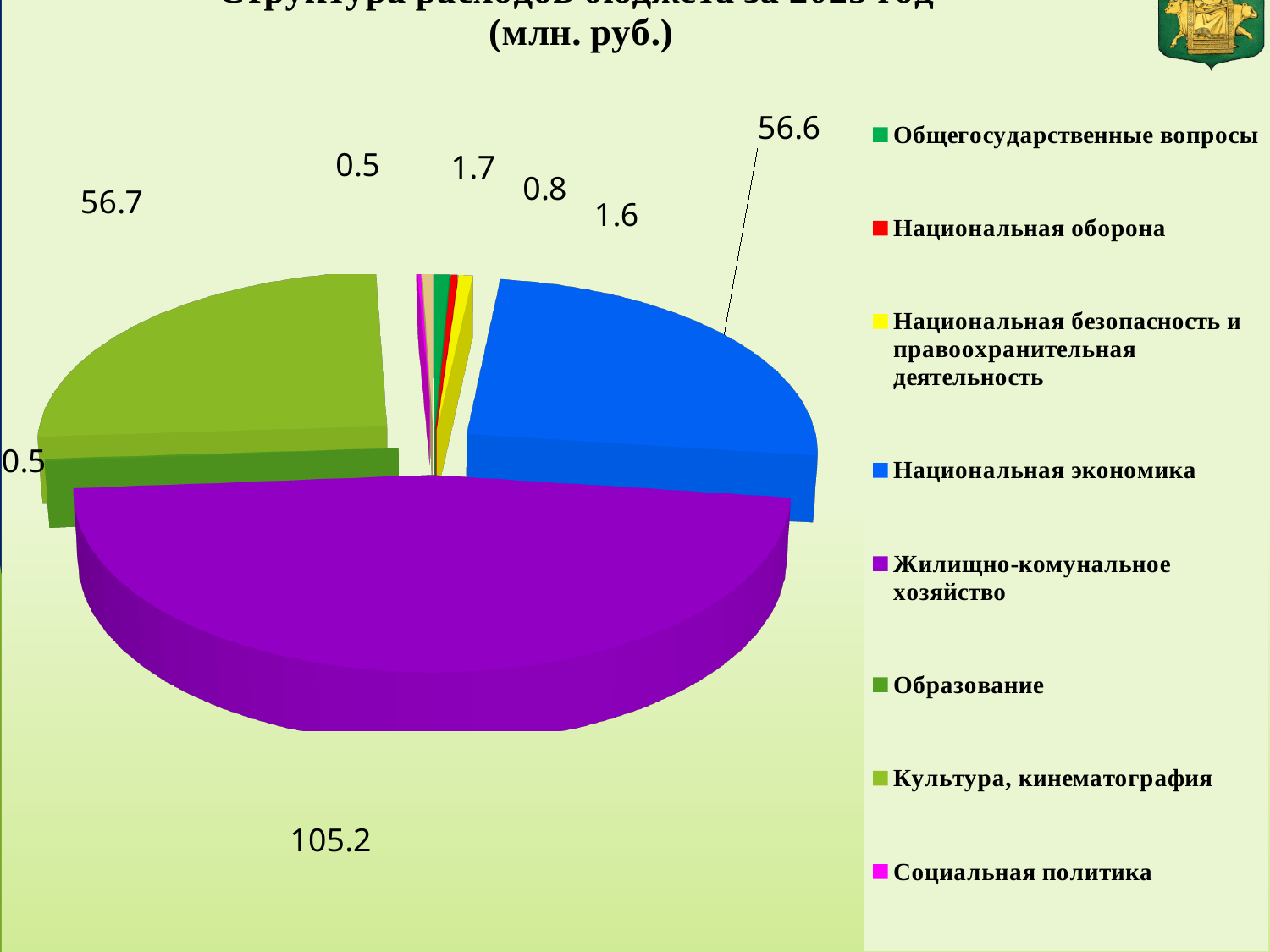
What is the value for Культура, кинематография? 56.7 What colour is the slice for Национальная экономика? blue What is the difference between the values for Культура, кинематография and Национальная экономика? 0.1 What kind of chart is shown on the slide? pie chart What is the value for Образование? 0.5 How many entries does the legend list? 8 What is the value for Национальная экономика? 56.6 Which is larger, the value for Жилищно-комунальное хозяйство or the value for Национальная экономика? Жилищно-комунальное хозяйство What is the difference between the values for Жилищно-комунальное хозяйство and Национальная экономика? 48.6 In what units are the values on the chart given, according to the title? млн. руб. Which category has the largest slice of the pie? Жилищно-комунальное хозяйство What is the value for Жилищно-комунальное хозяйство? 105.2